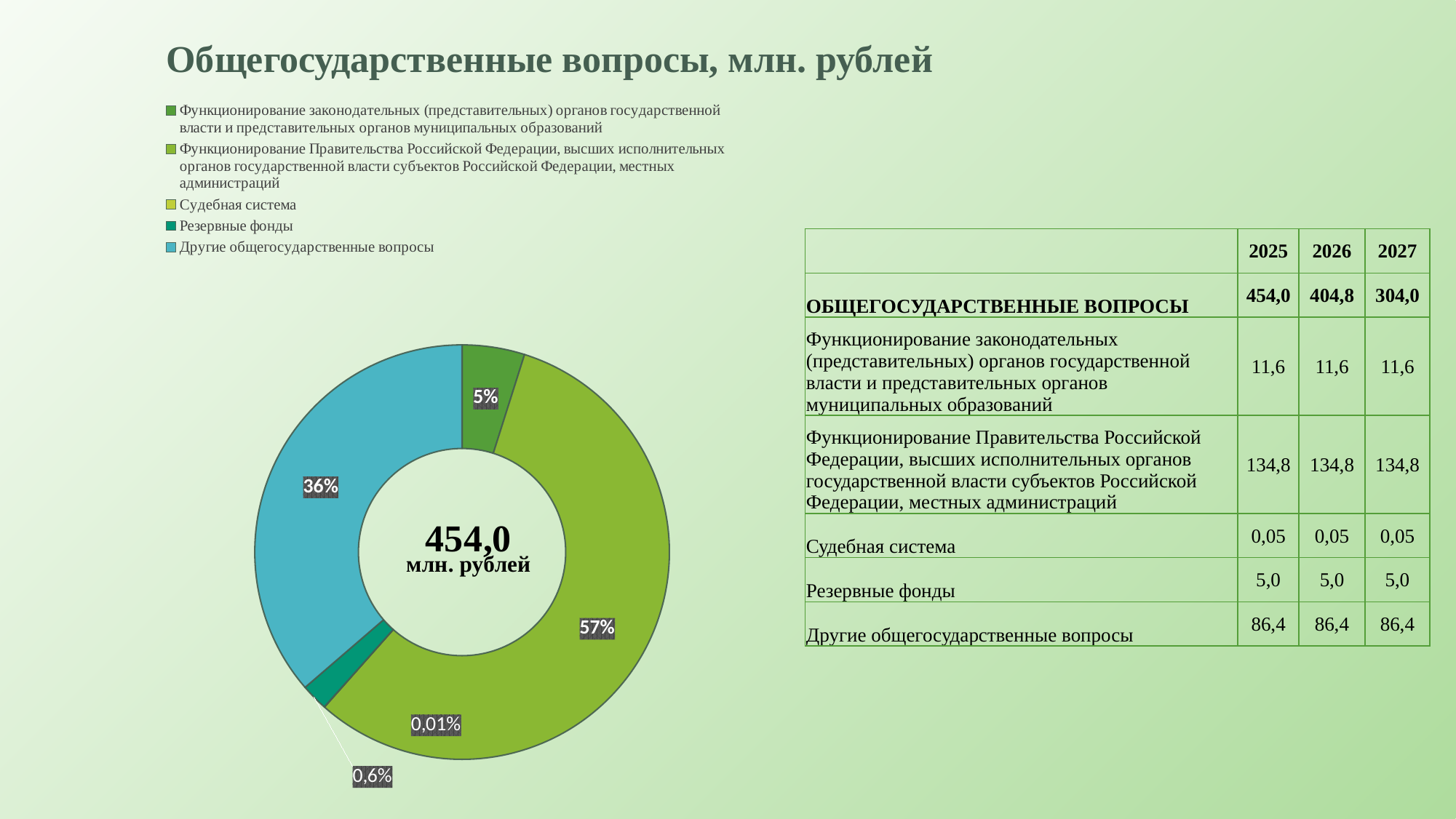
What share of the donut chart does "Функционирование законодательных (представительных) органов государственной власти и представительных органов муниципальных образований" take? 5% What total value is printed in the centre of the donut chart? 454,0 млн. рублей What is the title of the chart on the slide? Общегосударственные вопросы, млн. рублей What share of the donut chart does "Судебная система" take? 0,01% Which category has the smallest slice in the donut chart? Судебная система What kind of chart is shown on the slide? Donut (pie) chart What share of the donut chart does "Другие общегосударственные вопросы" take? 36% Which slice is larger in the donut chart: "Другие общегосударственные вопросы" or "Резервные фонды"? Другие общегосударственные вопросы Which category has the largest slice in the donut chart? Функционирование Правительства Российской Федерации, высших исполнительных органов государственной власти субъектов Российской Федерации, местных администраций How many categories does the legend of the donut chart list? 5